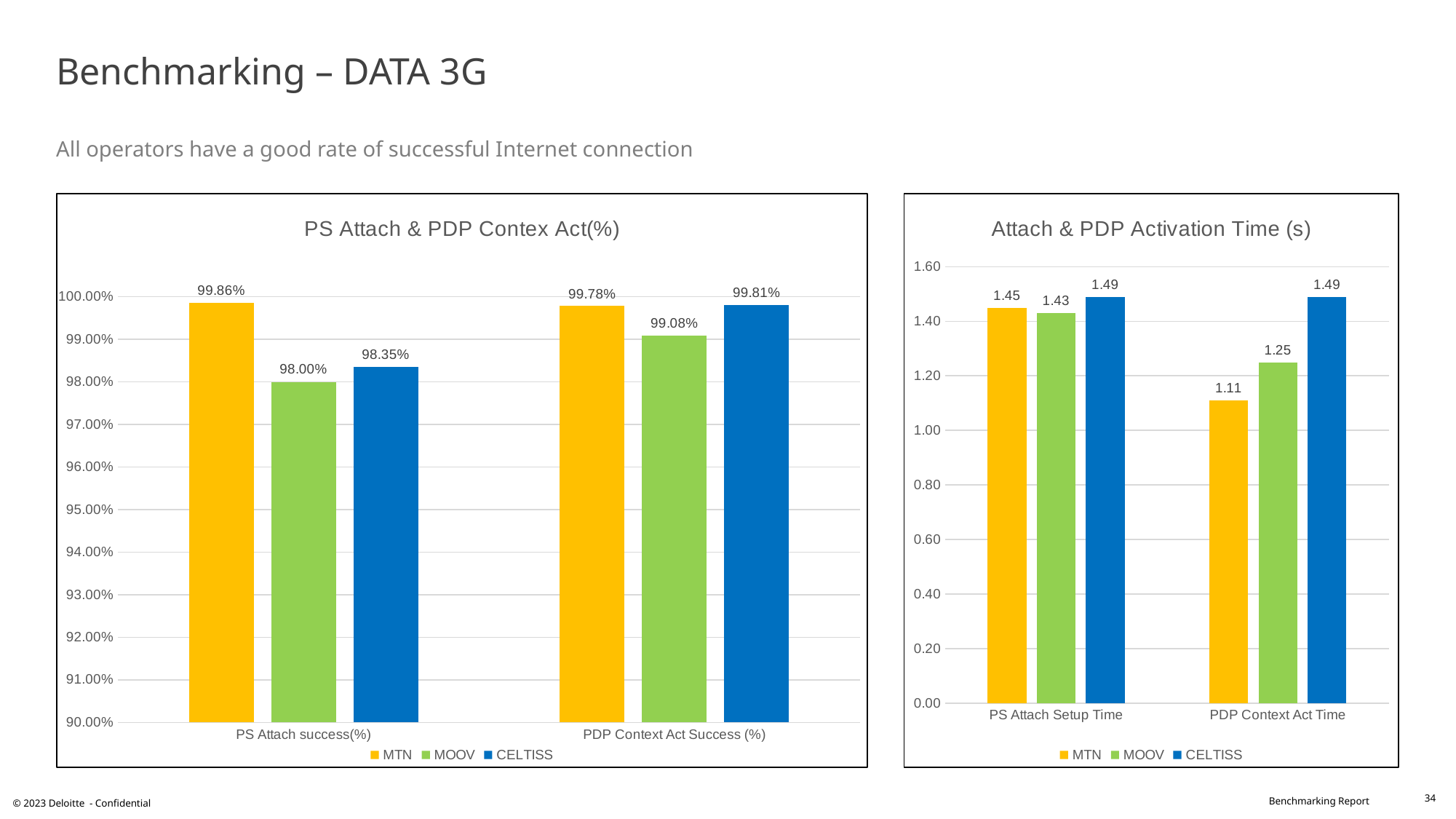
In the 'Attach & PDP Activation Time (s)' chart, what is the value for MTN in PDP Context Act Time? 1.11 In the 'PS Attach & PDP Contex Act(%)' chart, what is the value for MOOV in PDP Context Act Success (%)? 99.08% In the 'PS Attach & PDP Contex Act(%)' chart, what is the value for MTN in PS Attach success(%)? 99.86% In the 'Attach & PDP Activation Time (s)' chart, which operator has the lowest PDP Context Act Time? MTN In the 'Attach & PDP Activation Time (s)' chart, what is the difference between CELTISS and MOOV for PDP Context Act Time? 0.24 What kind of chart is 'PS Attach & PDP Contex Act(%)'? Bar chart In the 'PS Attach & PDP Contex Act(%)' chart, which operator has the lowest PS Attach success(%)? MOOV In the 'Attach & PDP Activation Time (s)' chart, what is the value for CELTISS in PS Attach Setup Time? 1.49 In the 'Attach & PDP Activation Time (s)' chart, is the value for MOOV in PDP Context Act Time greater or less than 1.20? greater In the 'Attach & PDP Activation Time (s)' chart, how many categories are shown on the x axis? 2 In the 'PS Attach & PDP Contex Act(%)' chart, what is the difference between MTN and CELTISS for PS Attach success(%)? 1.51% In the 'PS Attach & PDP Contex Act(%)' chart, how many series does the legend list? 3